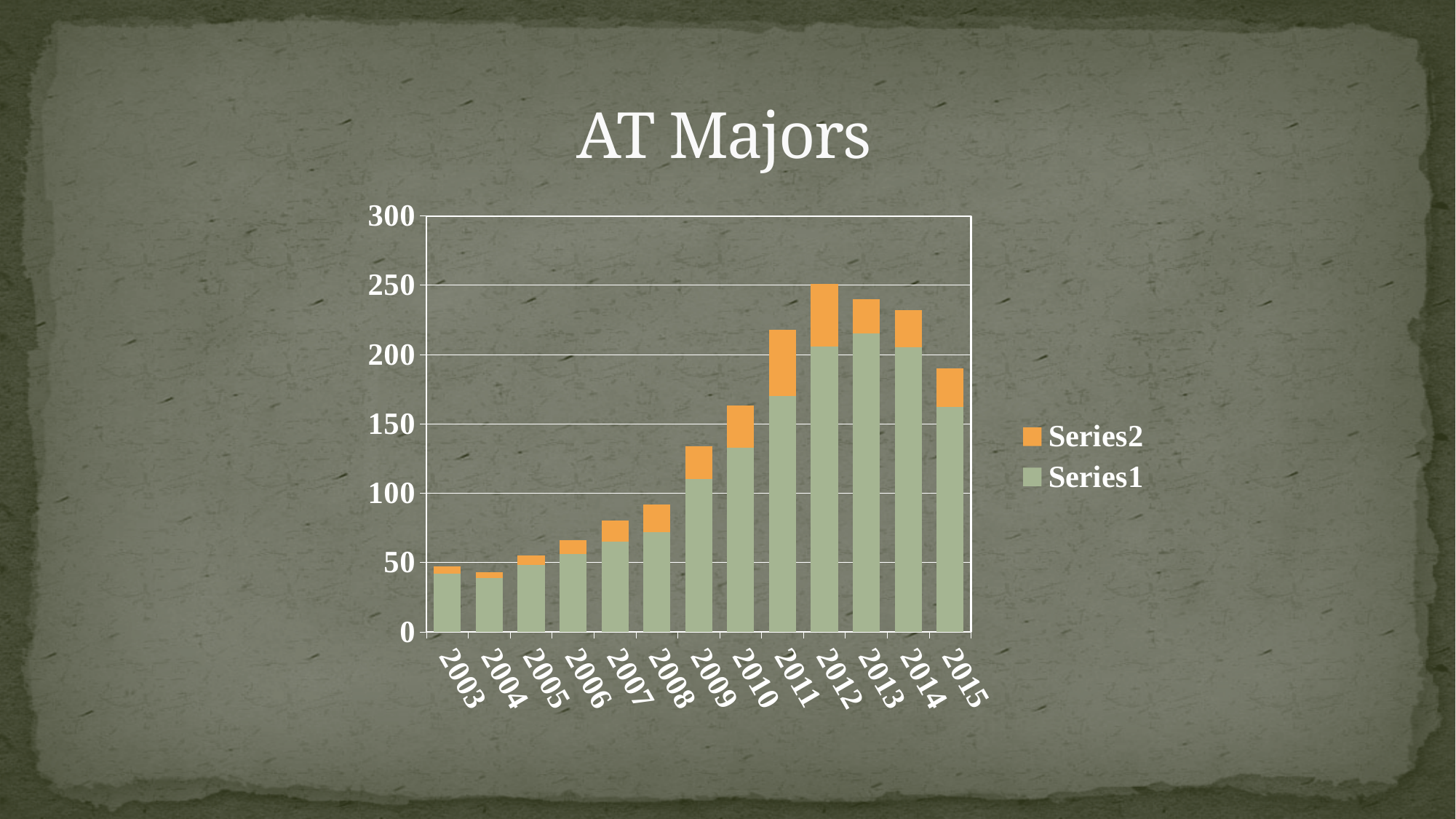
What kind of chart is shown on the slide? Stacked bar chart What is the title of the chart? AT Majors Is the total stacked value for 2012 greater or less than 200? greater Which year has the tallest stacked bar? 2012 How many years are shown along the x axis? 13 Is the total stacked value for 2015 greater or less than 200? less Do the stacked bar totals generally rise or fall from 2003 to 2012? rise Which year has the larger total stacked bar, 2009 or 2014? 2014 Which year has the shortest stacked bar? 2004 Is the Series1 value for 2011 greater or less than 150? greater How many series does the legend list? 2